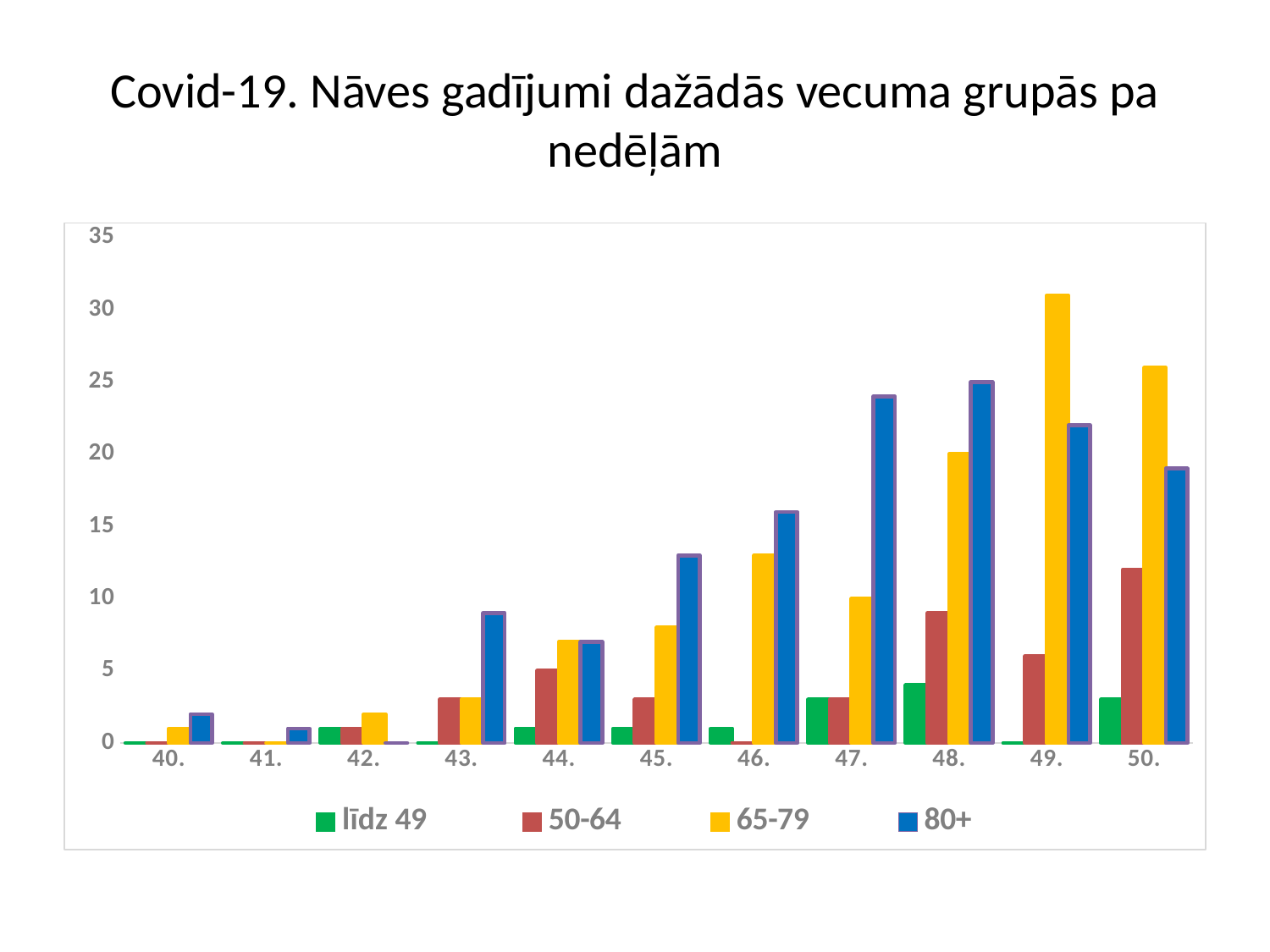
How many series does the legend list? 4 Do the values for the 80+ series generally rise or fall from week 40 to week 48? rise Is the value for 50-64 in week 50 greater or less than 10? greater Which is larger in week 47: the 65-79 value or the 80+ value? 80+ In which week is the 65-79 series at its highest? 49. Is the value for 65-79 in week 49 greater or less than 30? greater In which week is the 80+ series at its highest? 48. How many weeks (categories) are shown on the x axis? 11 What kind of chart is shown on the slide? bar chart Which is larger in week 50: the 65-79 value or the 80+ value? 65-79 What is the title of the chart? Covid-19. Nāves gadījumi dažādās vecuma grupās pa nedēļām Is the value for 80+ in week 50 greater or less than 20? less